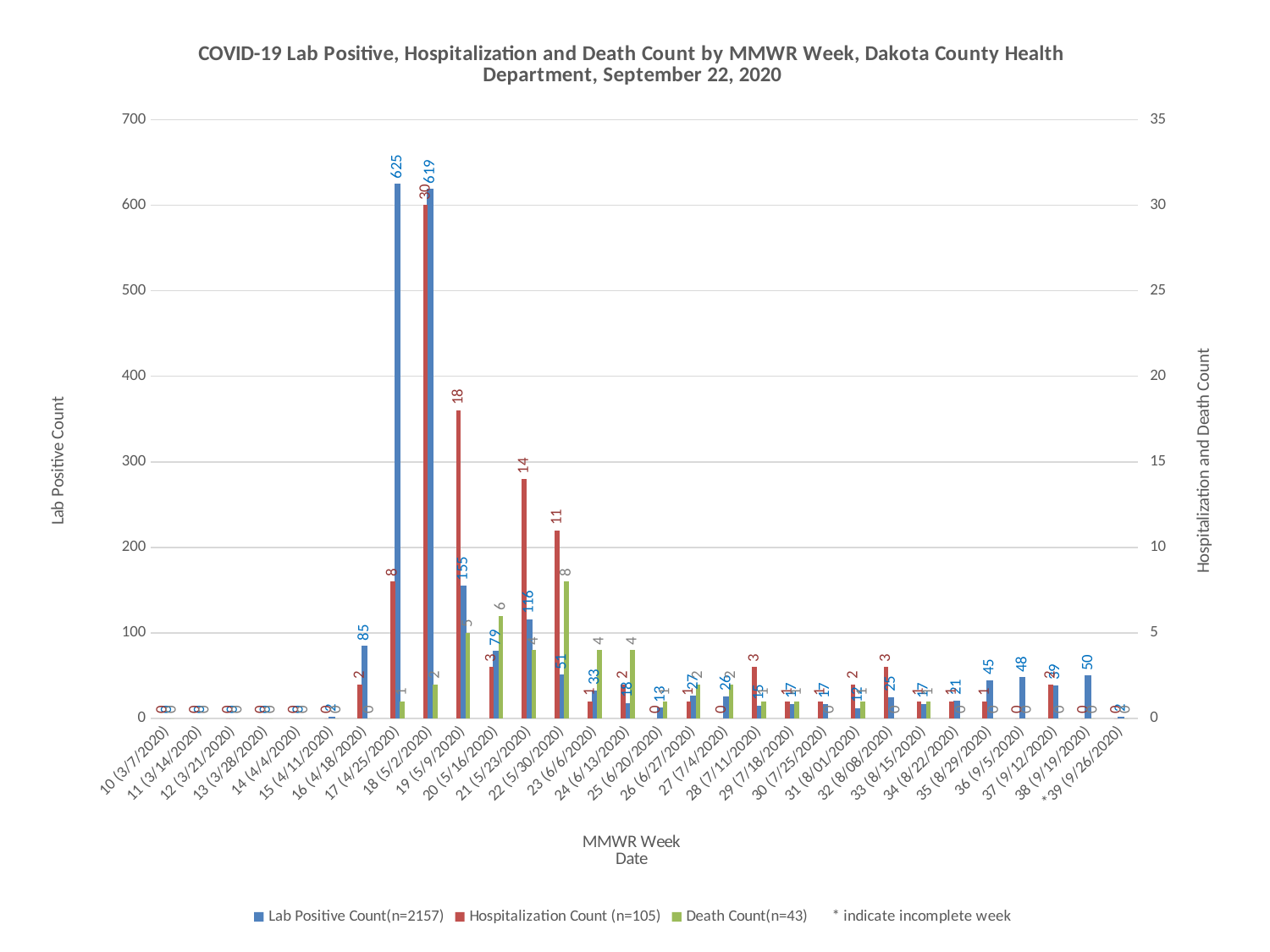
What is the Death Count for MMWR week 22 (5/30/2020)? 8 What kind of chart is shown on the slide? Bar chart How many MMWR weeks are shown on the x axis? 30 Which has the larger Lab Positive Count: week 19 (5/9/2020) or week 21 (5/23/2020)? Week 19 (5/9/2020) What is the difference between the Lab Positive Count for week 17 (4/25/2020) and week 18 (5/2/2020)? 6 What is the label of the right-hand vertical axis? Hospitalization and Death Count Which MMWR week has the highest Death Count? 22 (5/30/2020) What is the Hospitalization Count for MMWR week 18 (5/2/2020)? 30 What is the Hospitalization Count for MMWR week 19 (5/9/2020)? 18 How many data series does the legend list? 3 What is the Lab Positive Count for MMWR week 17 (4/25/2020)? 625 Which MMWR week has the highest Lab Positive Count? 17 (4/25/2020)